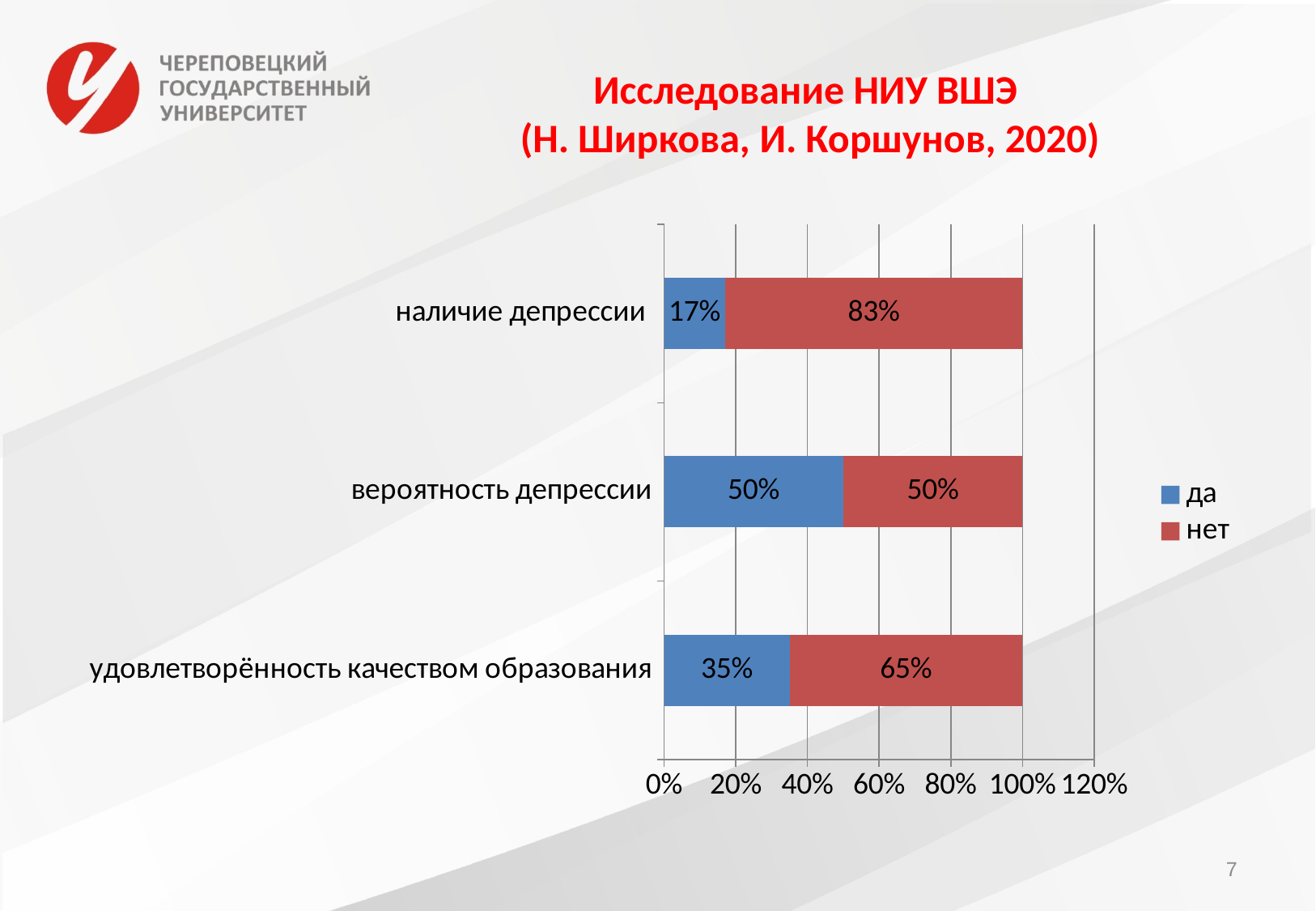
What is the value of "да" for "вероятность депрессии"? 50% What is the difference between the "нет" and "да" values for "удовлетворённость качеством образования"? 30% Which is larger for "наличие депрессии": the "да" value or the "нет" value? нет How many series does the legend list? 2 What is the value of "нет" for "удовлетворённость качеством образования"? 65% What is the value of "да" for "наличие депрессии"? 17% What is the total of the stacked bar for "вероятность депрессии"? 100% What kind of chart is shown on the slide? Stacked bar chart Which colour represents the "нет" series? Red Which category has the highest "нет" value? наличие депрессии How many categories are shown on the chart? 3 Which category has the lowest "да" value? наличие депрессии